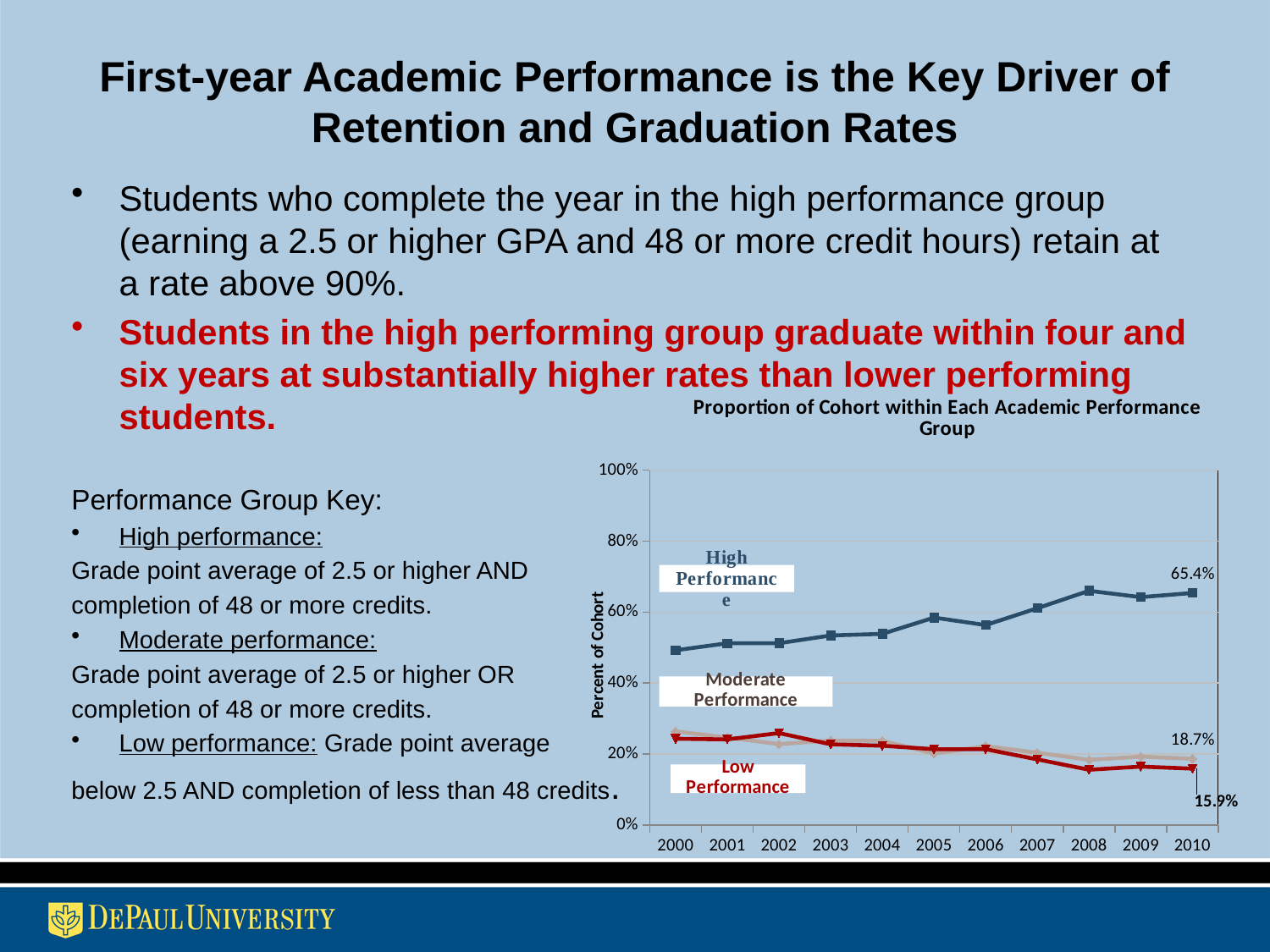
What is the title of the chart? Proportion of Cohort within Each Academic Performance Group How many years are shown on the x axis of the chart? 11 What is the value for the Moderate Performance group in 2010? 18.7% What is the value for the Low Performance group in 2010? 15.9% Which performance group has the highest value in 2010? High Performance Does the High Performance line generally rise or fall from 2000 to 2010? rise What is the label on the vertical axis of the chart? Percent of Cohort Is the value for the High Performance group in 2000 greater or less than 40%? greater What is the value for the High Performance group in 2010? 65.4% What kind of chart is shown on the slide? line chart What is the difference between the High Performance and Low Performance values in 2010? 49.5 percentage points What is the difference between the Moderate Performance and Low Performance values in 2010? 2.8 percentage points